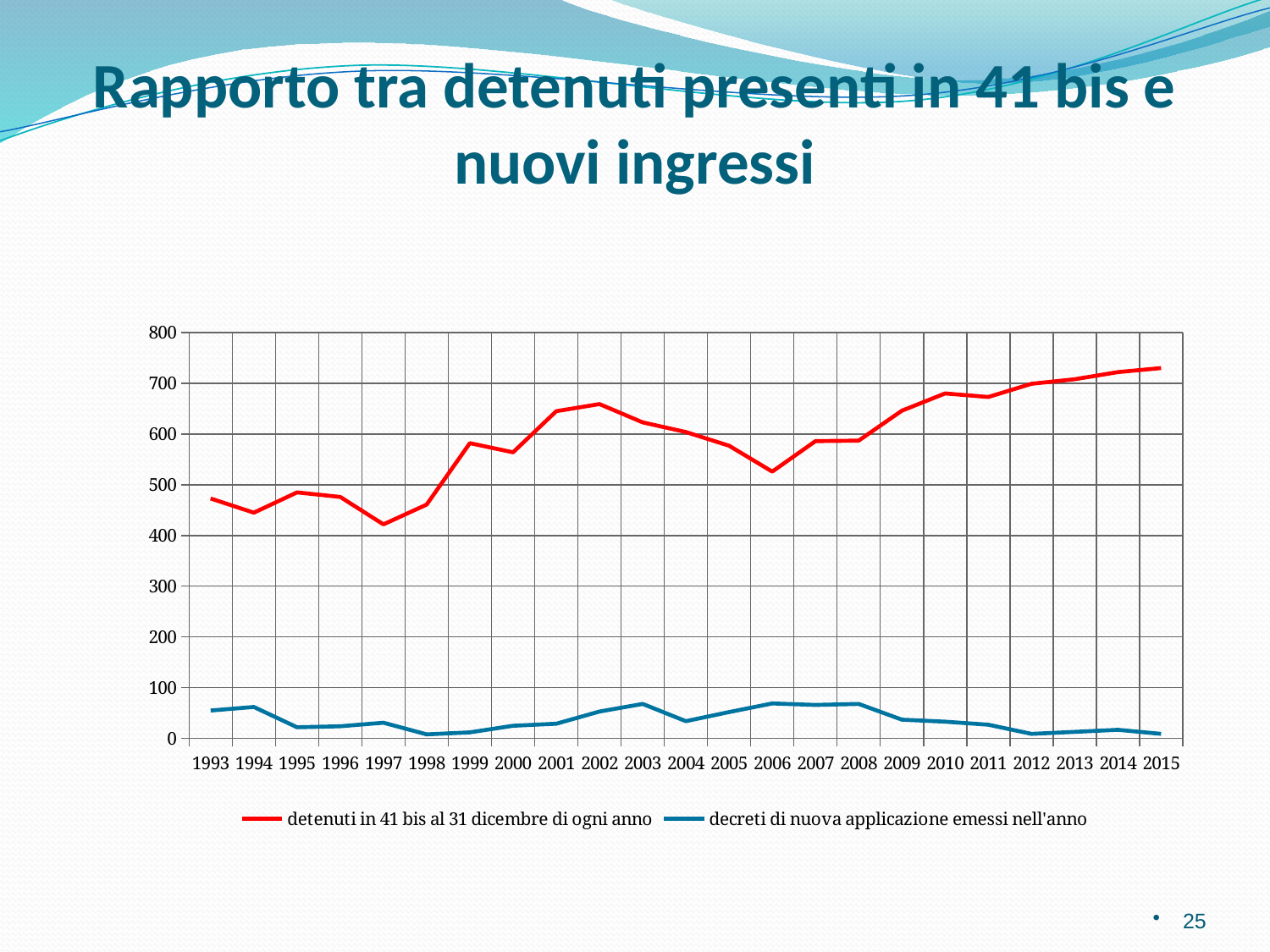
Does the 'detenuti in 41 bis al 31 dicembre di ogni anno' line rise or fall from 2006 to 2015? rise What kind of chart is shown on the slide? line chart How many series does the legend list? 2 What is the title of the chart on the slide? Rapporto tra detenuti presenti in 41 bis e nuovi ingressi Is the value for 'detenuti in 41 bis al 31 dicembre di ogni anno' in 1997 greater or less than 500? less Which is larger for 'detenuti in 41 bis al 31 dicembre di ogni anno': the value in 2002 or the value in 2006? 2002 Is the value for 'detenuti in 41 bis al 31 dicembre di ogni anno' in 2002 greater or less than 600? greater Is the value for 'detenuti in 41 bis al 31 dicembre di ogni anno' in 2015 greater or less than 700? greater How many years are shown on the x axis? 23 Which year has the highest value for 'detenuti in 41 bis al 31 dicembre di ogni anno'? 2015 Which year has the lowest value for 'detenuti in 41 bis al 31 dicembre di ogni anno'? 1997